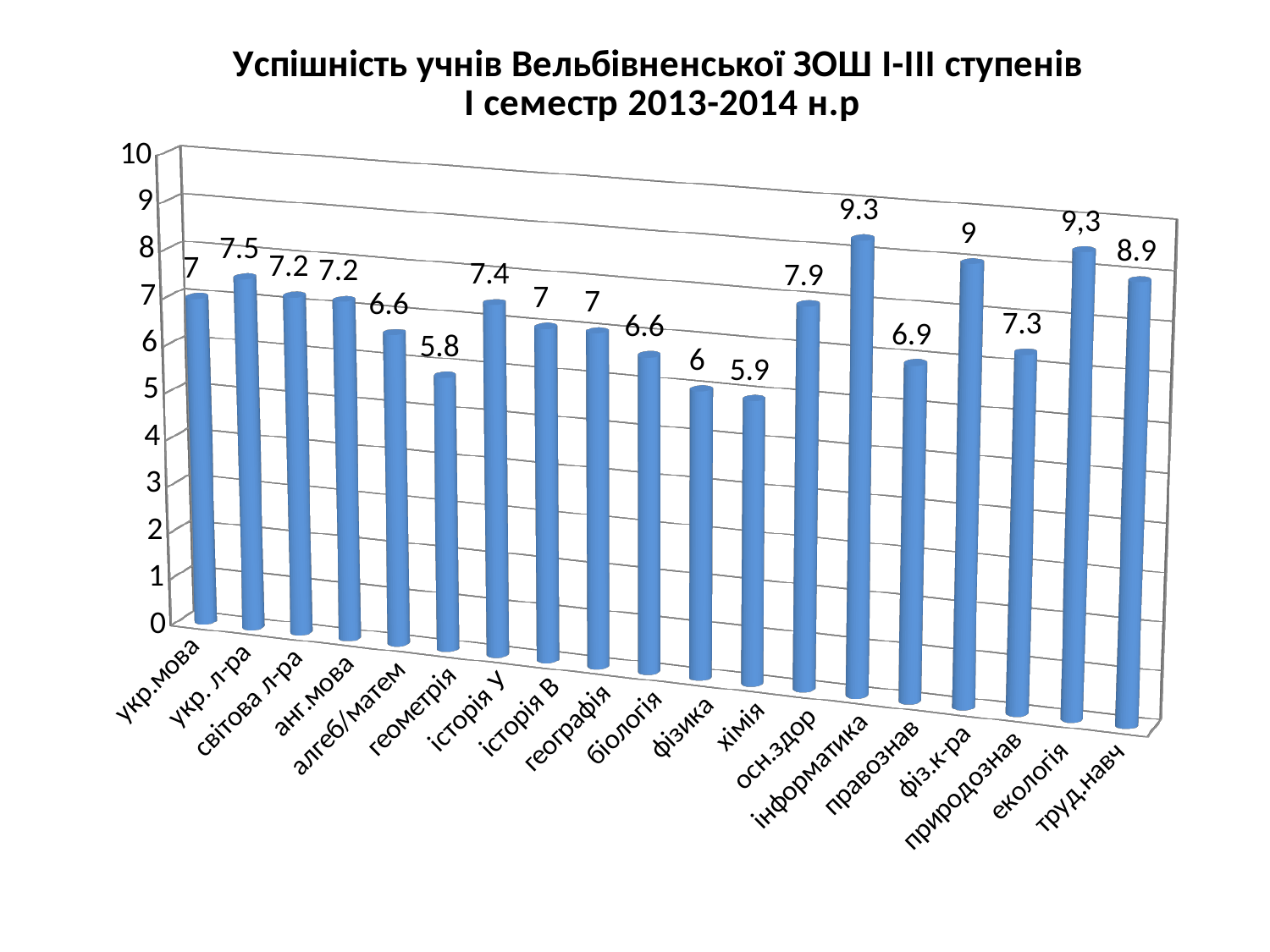
What is the value for геометрія? 5.8 What is the difference between the values for укр. л-ра and укр.мова? 0.5 What is the value for інформатика? 9.3 Is the value for хімія greater or less than 6? less Which category has the lowest value? геометрія What is the value for осн.здор? 7.9 How many categories are shown on the x axis? 19 Which is larger, the value for історія У or the value for історія В? історія У What is the title of the chart? Успішність учнів Вельбівненської ЗОШ І-ІІІ ступенів І семестр 2013-2014 н.р What kind of chart is shown on the slide? bar chart What is the value for труд.навч? 8.9 What is the difference between the values for фіз.к-ра and правознав? 2.1